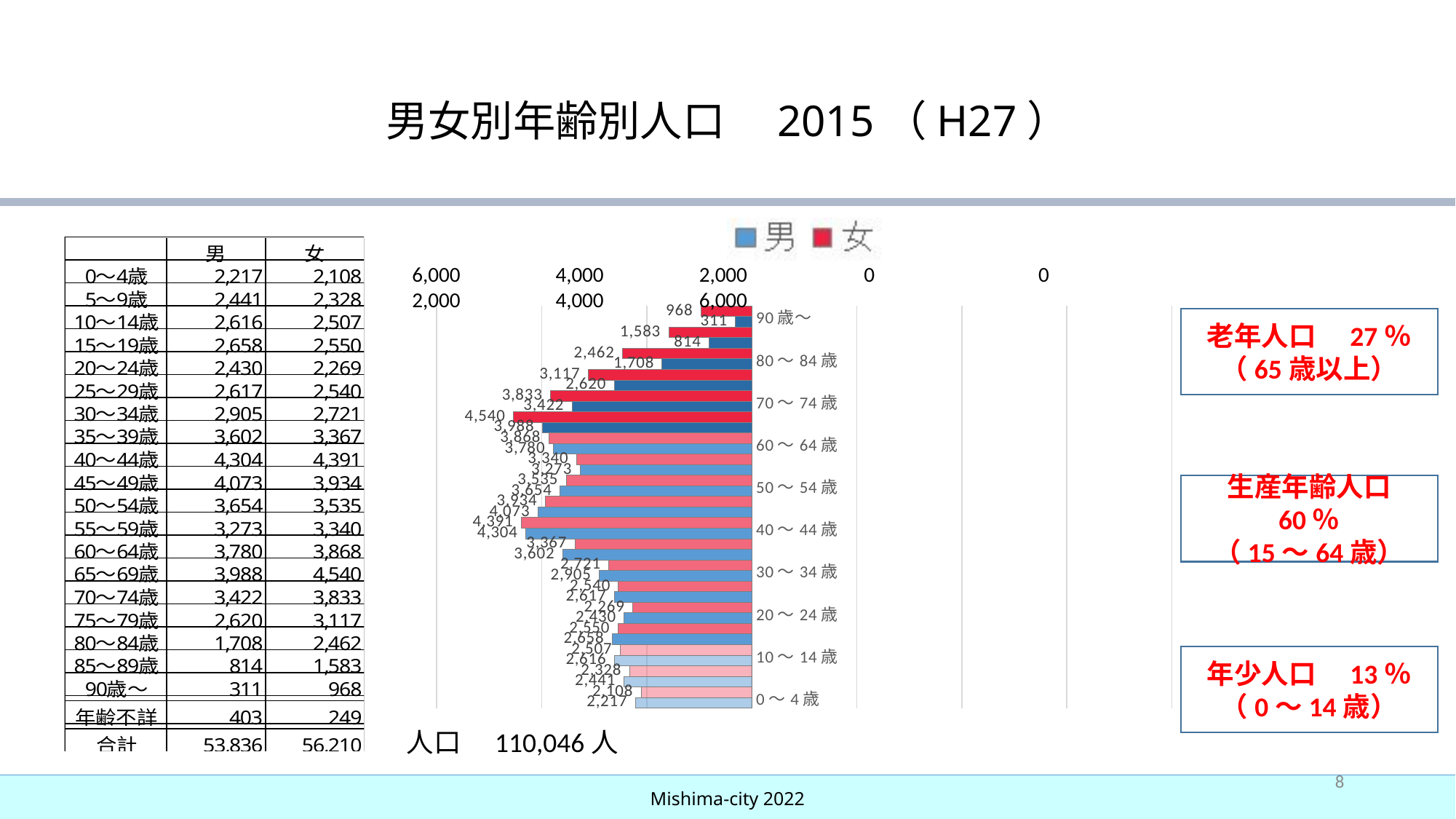
What is the value for 男 in the 90歳〜 age group? 311 Which age group has the highest value for 女? 65〜69歳 What kind of chart is shown on the slide? bar chart What is the value for 女 in the 65〜69歳 age group? 4,540 Which colour represents 女 in the chart legend? red Is the value for 男 in the 35〜39歳 age group greater or less than 4,000? less What is the difference between the 女 and 男 values in the 80〜84歳 age group? 754 How many age groups are plotted on the chart? 19 Which age group has the lowest value for 男? 90歳〜 What is the value for 男 in the 40〜44歳 age group? 4,304 In the 0〜4歳 age group, which is larger, 男 or 女? 男 How many series does the chart legend list? 2